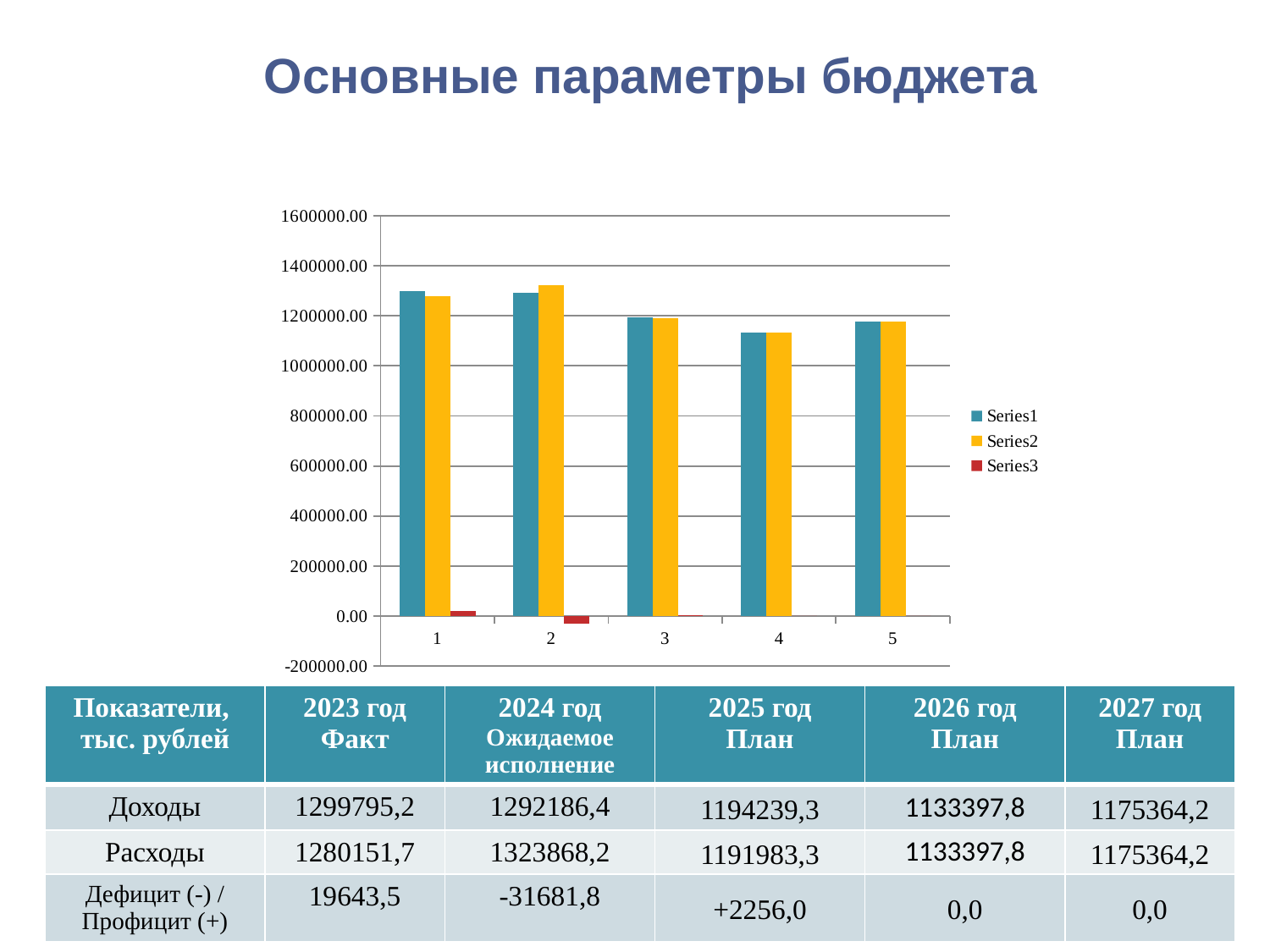
Is the value of Series3 for category 2 greater or less than 0.00? less How many categories are shown on the x axis of the chart? 5 Do the Series1 values rise or fall from category 1 to category 4? fall Is the value of Series1 for category 4 greater or less than 1200000.00? less For which category is Series2 highest? 2 Is the value of Series1 for category 1 greater or less than 1200000.00? greater For category 2, which is larger: Series1 or Series2? Series2 What kind of chart is shown on the slide? bar chart For which category is Series1 lowest? 4 How many series does the chart legend list? 3 What is the highest value shown on the chart's y axis? 1600000.00